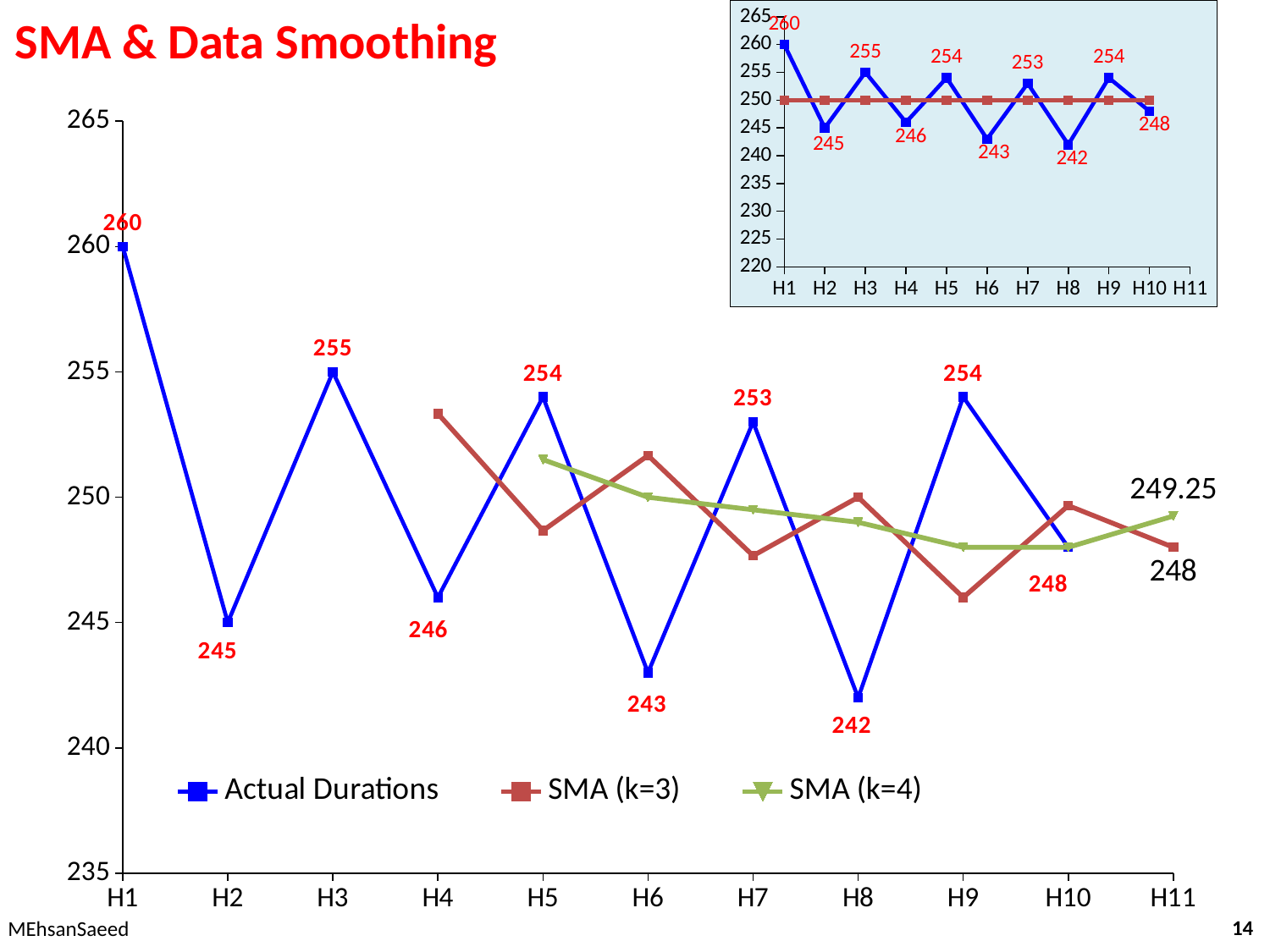
On the large main chart, at which half-year is the Actual Durations value lowest? H8 On the large main chart, what is the Actual Durations value at H8? 242 On the large main chart, which is larger: the Actual Durations value at H3 or at H7? H3 On the large main chart, is the SMA (k=3) value at H4 greater or less than 250? greater On the large main chart, what is the Actual Durations value at H1? 260 On the large main chart, what is the SMA (k=4) value at H11? 249.25 On the large main chart, what is the difference between the Actual Durations values at H1 and H2? 15 On the large main chart, what is the SMA (k=3) value at H11? 248 What kind of chart is the large main chart? Line chart How many series does the legend of the large main chart list? 3 On the small inset chart at the top right, what is the value labelled at H6? 243 On the large main chart, at which half-year is the Actual Durations value highest? H1